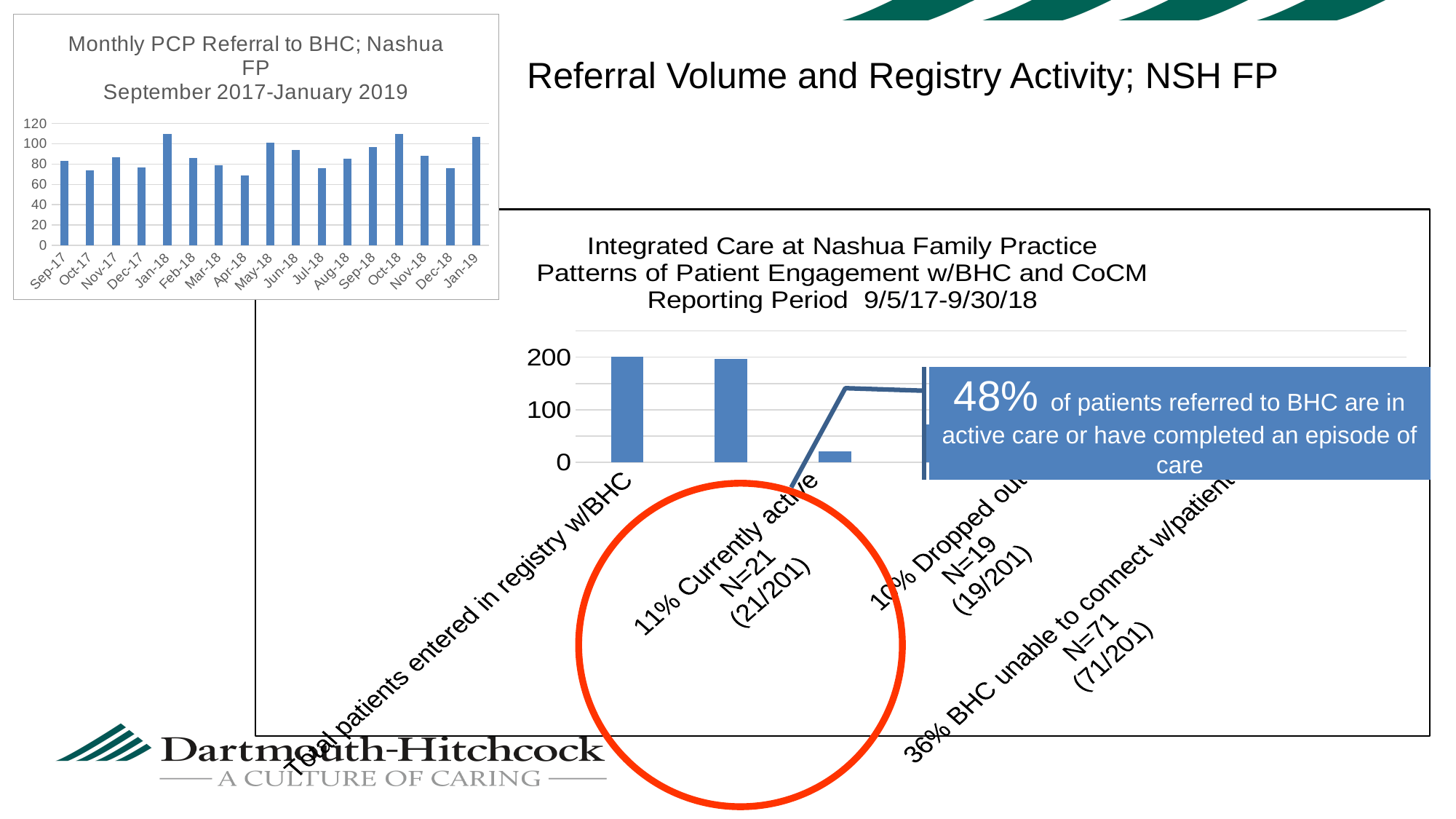
In the 'Monthly PCP Referral to BHC; Nashua FP' chart, which month has the lowest number of referrals? Apr-18 In the 'Monthly PCP Referral to BHC; Nashua FP' chart, is the value for Apr-18 greater or less than 80? less What kind of chart is the 'Monthly PCP Referral to BHC; Nashua FP' chart? Bar chart In the 'Integrated Care at Nashua Family Practice' chart, what is the N for patients who dropped out? N=19 In the 'Integrated Care at Nashua Family Practice' chart, what is the N for patients BHC was unable to connect with? N=71 In the 'Monthly PCP Referral to BHC; Nashua FP' chart, is the value for Oct-17 greater or less than 80? less In the 'Integrated Care at Nashua Family Practice' chart, what percentage of patients referred to BHC are in active care or have completed an episode of care, according to the callout? 48% In the 'Integrated Care at Nashua Family Practice' chart, what reporting period is stated in the title? 9/5/17-9/30/18 In the 'Monthly PCP Referral to BHC; Nashua FP' chart, is the value for Jan-18 greater or less than 100? greater In the 'Monthly PCP Referral to BHC; Nashua FP' chart, which month has more referrals, Jan-18 or Apr-18? Jan-18 In the 'Monthly PCP Referral to BHC; Nashua FP' chart, how many months are shown on the x axis? 17 In the 'Integrated Care at Nashua Family Practice' chart, what is the N for patients currently active? N=21